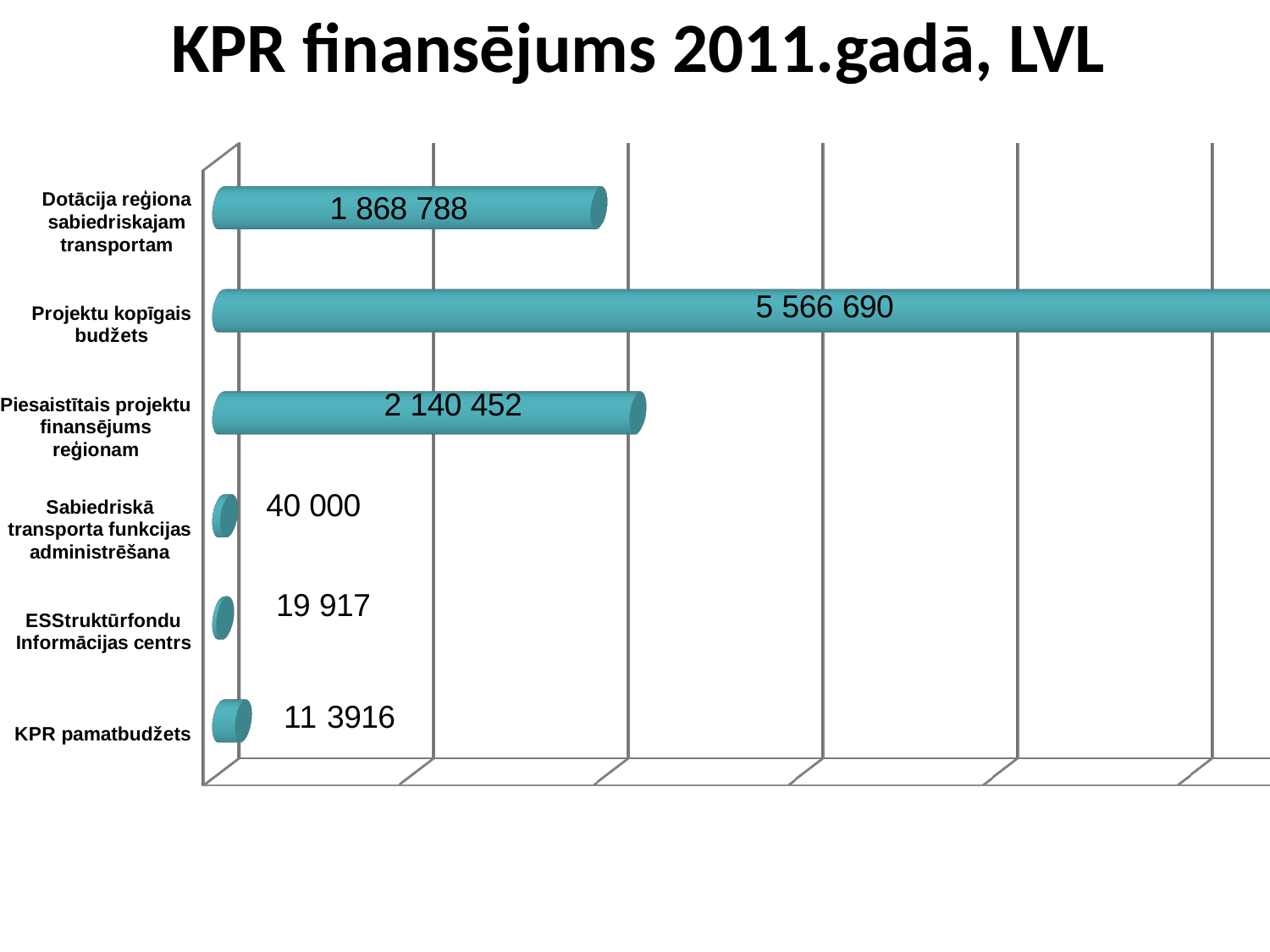
What is the difference between Sabiedriskā transporta funkcijas administrēšana and ESStruktūrfondu Informācijas centrs? 20 083 What is the value for ESStruktūrfondu Informācijas centrs? 19 917 Which category has the highest value? Projektu kopīgais budžets How many categories are shown in the chart? 6 What type of chart is shown on the slide? Bar chart What is the value for Sabiedriskā transporta funkcijas administrēšana? 40 000 What is the value for Piesaistītais projektu finansējums reģionam? 2 140 452 What is the value for Projektu kopīgais budžets? 5 566 690 Which is larger: Piesaistītais projektu finansējums reģionam or Dotācija reģiona sabiedriskajam transportam? Piesaistītais projektu finansējums reģionam What is the value for Dotācija reģiona sabiedriskajam transportam? 1 868 788 Which category has the lowest value? ESStruktūrfondu Informācijas centrs What is the difference between Piesaistītais projektu finansējums reģionam and Dotācija reģiona sabiedriskajam transportam? 271 664